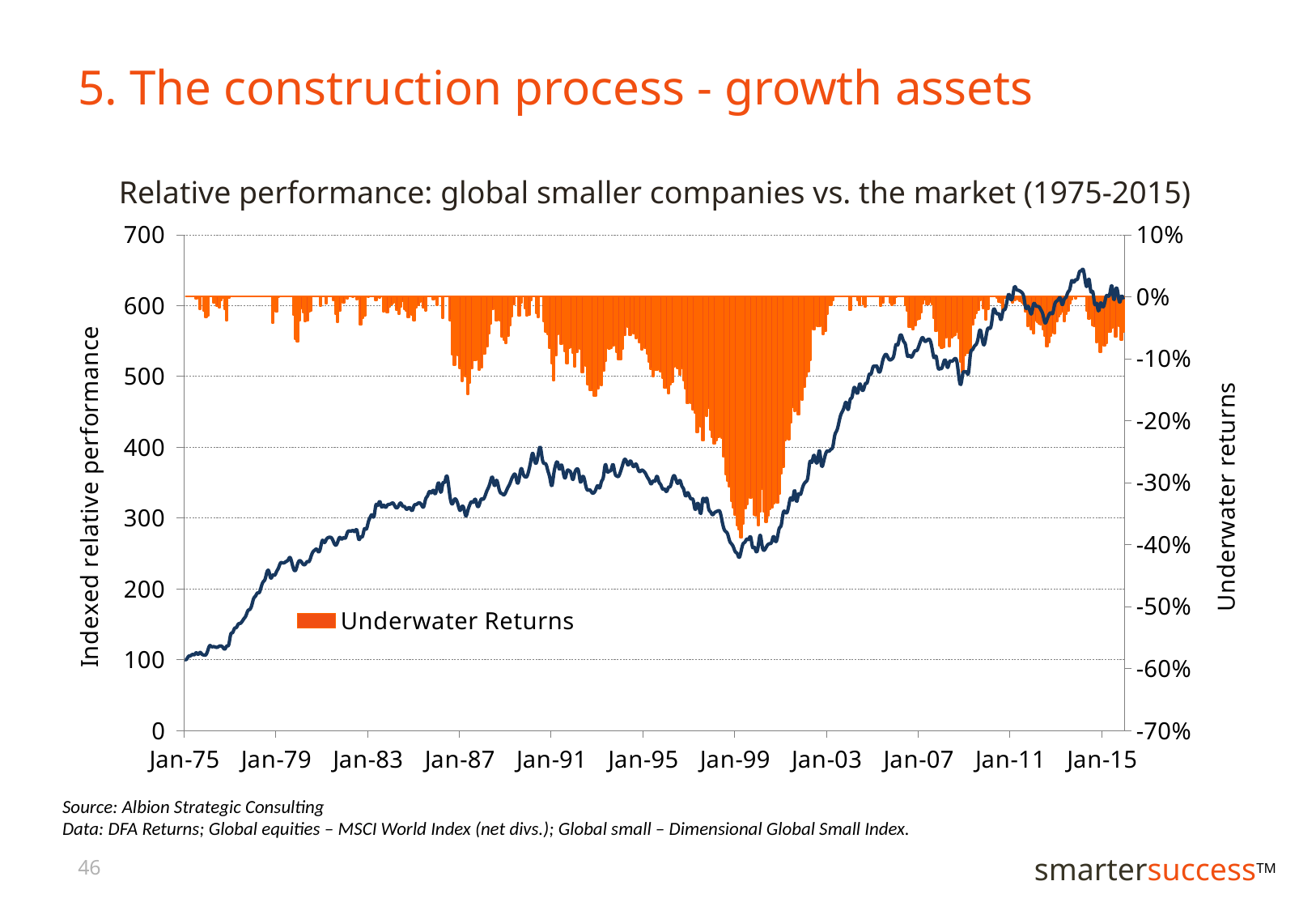
What is the label of the left vertical axis? Indexed relative performance Is the indexed relative performance line at Jan-99 greater or less than 300? less Does the indexed relative performance line rise or fall between Jan-91 and Jan-99? fall What kind of chart is shown on the slide? A combined line and bar chart Does the indexed relative performance line rise or fall between Jan-75 and Jan-83? rise How many series does the legend list? 1 Is the indexed relative performance line at Jan-79 greater or less than 200? greater What is the title of the chart? Relative performance: global smaller companies vs. the market (1975-2015) Is the indexed relative performance line at Jan-07 greater or less than 500? greater How many tick labels are shown on the x axis? 11